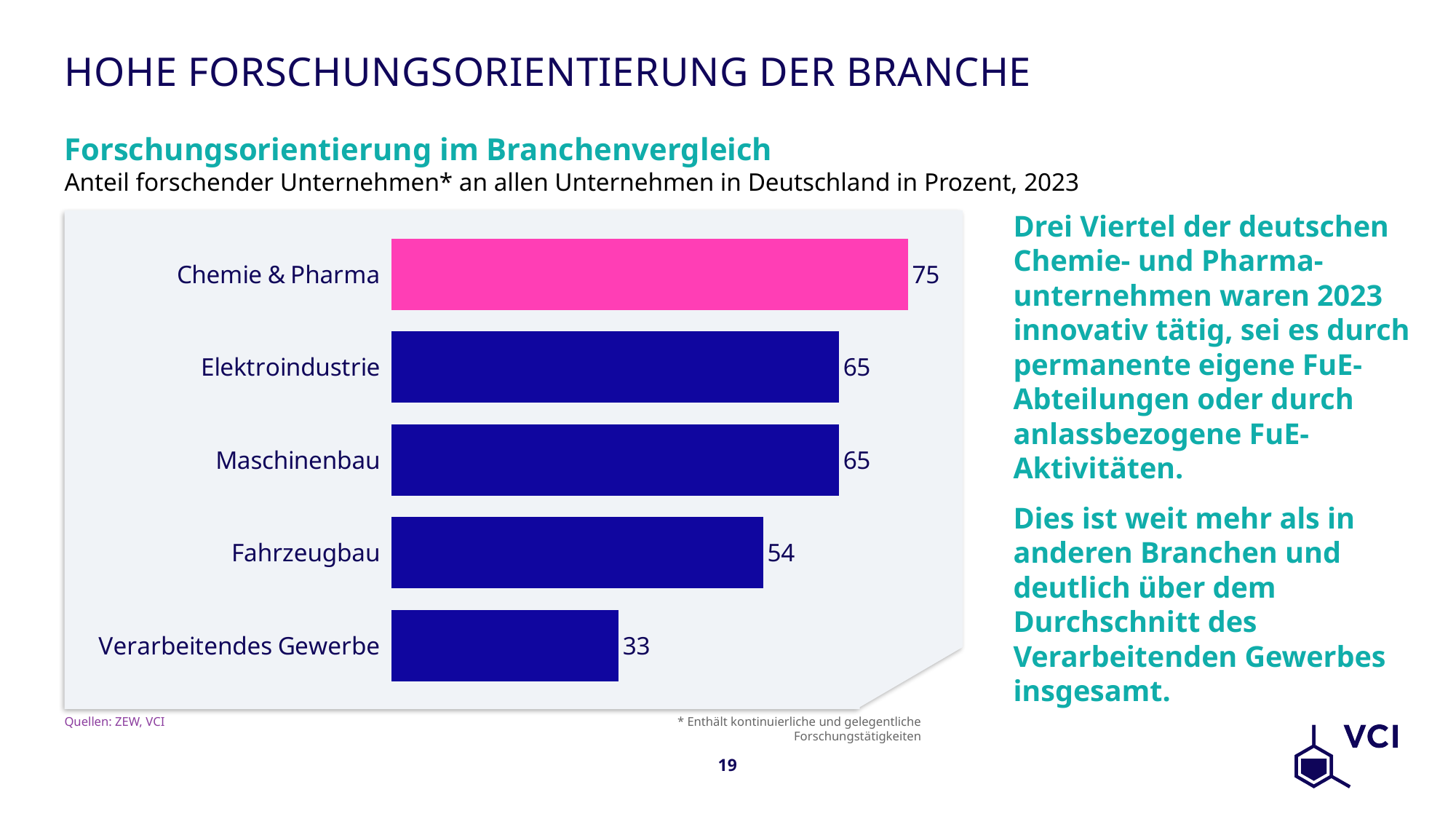
What is the value for Fahrzeugbau? 54 Which bar is highlighted in a different colour (pink) from the others? Chemie & Pharma What is the difference between the values for Maschinenbau and Fahrzeugbau? 11 What is the value for Verarbeitendes Gewerbe? 33 How many categories are shown in the chart? 5 What is the value for Chemie & Pharma? 75 What kind of chart is shown on the slide? bar chart Which category has the lowest value? Verarbeitendes Gewerbe What is the difference between the values for Chemie & Pharma and Verarbeitendes Gewerbe? 42 What is the value for Elektroindustrie? 65 Which is larger, the value for Fahrzeugbau or the value for Elektroindustrie? Elektroindustrie Which category has the highest value? Chemie & Pharma